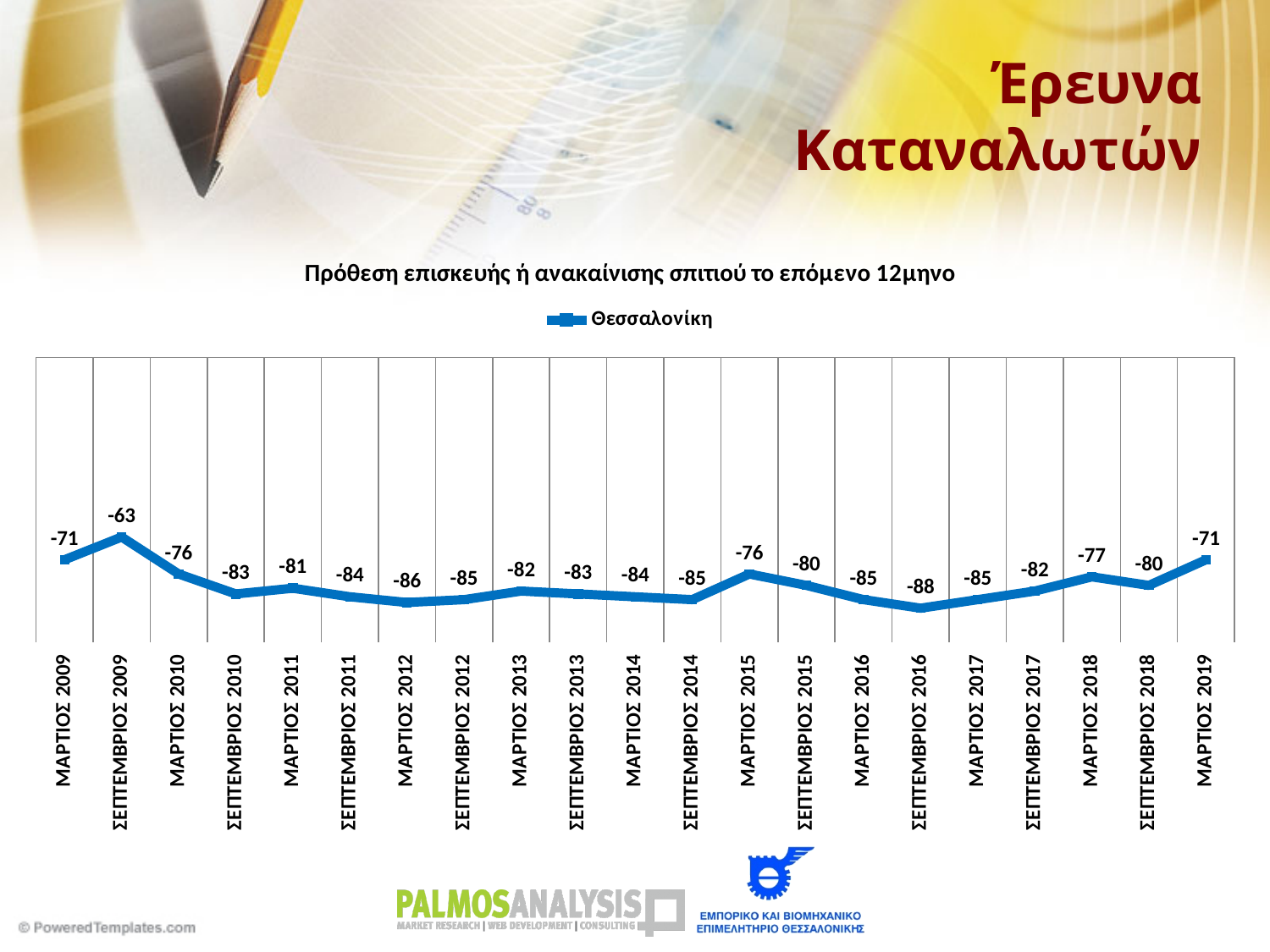
How many series does the legend list? 1 What is the title of the chart? Πρόθεση επισκευής ή ανακαίνισης σπιτιού το επόμενο 12μηνο What is the difference between the values for ΜΑΡΤΙΟΣ 2019 and ΣΕΠΤΕΜΒΡΙΟΣ 2016? 17 What is the value for ΣΕΠΤΕΜΒΡΙΟΣ 2016? -88 What is the value for ΜΑΡΤΙΟΣ 2019? -71 Which period has the highest value? ΣΕΠΤΕΜΒΡΙΟΣ 2009 What type of chart is shown on the slide? Line chart Which period has the lowest value? ΣΕΠΤΕΜΒΡΙΟΣ 2016 How many data points are plotted on the chart? 21 What is the difference between the values for ΣΕΠΤΕΜΒΡΙΟΣ 2009 and ΜΑΡΤΙΟΣ 2012? 23 What is the value for ΜΑΡΤΙΟΣ 2015? -76 Which is larger, the value for ΜΑΡΤΙΟΣ 2018 or the value for ΣΕΠΤΕΜΒΡΙΟΣ 2018? ΜΑΡΤΙΟΣ 2018